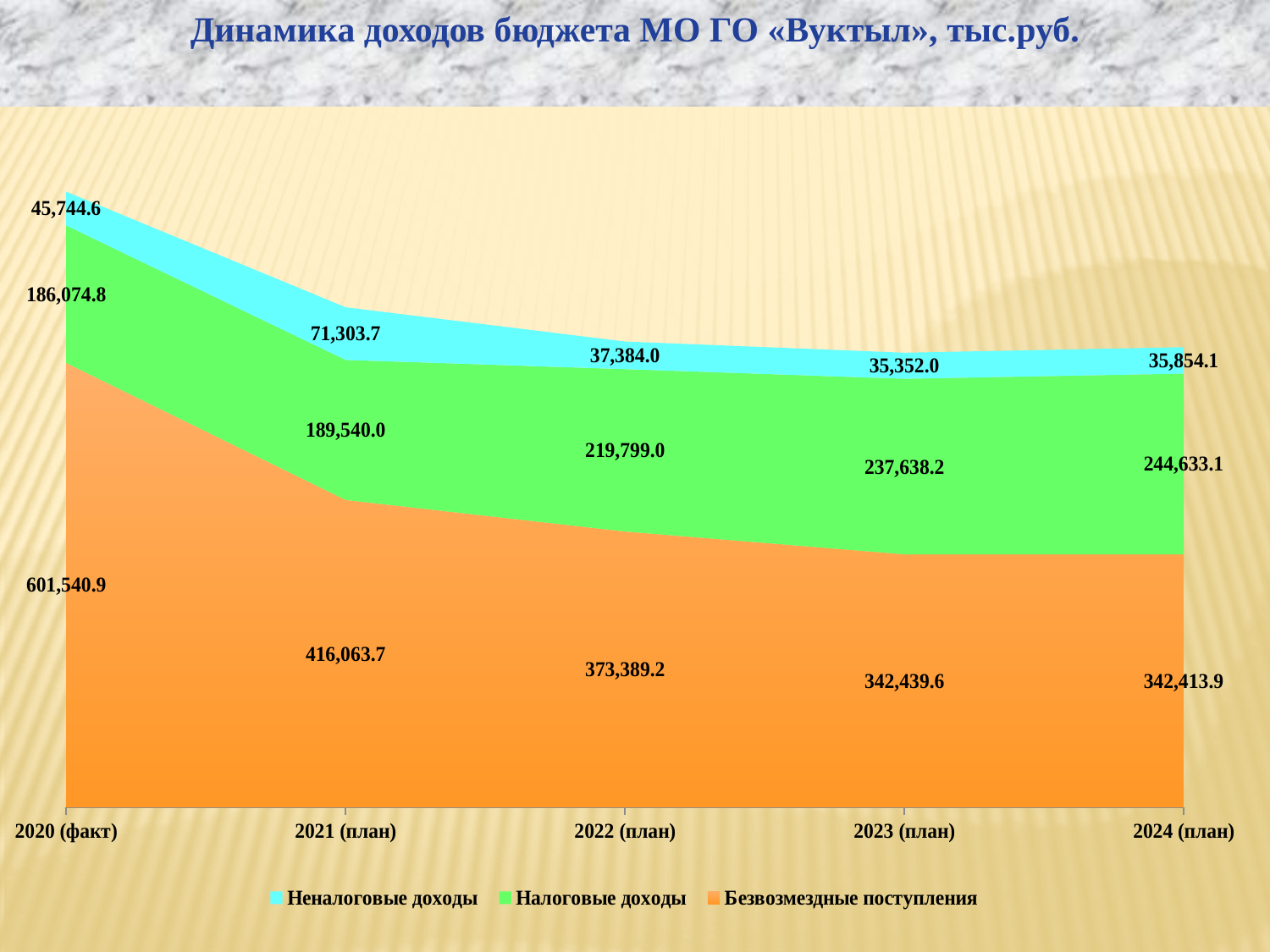
What is the total of all three series for 2024 (план)? 622,901.1 What is the difference between Налоговые доходы in 2024 (план) and in 2020 (факт)? 58,558.3 What is the value of Безвозмездные поступления for 2020 (факт)? 601,540.9 In which period is Неналоговые доходы highest? 2021 (план) What is the value of Налоговые доходы for 2022 (план)? 219,799.0 In which period is Безвозмездные поступления lowest? 2024 (план) How many series does the legend list? 3 What type of chart is shown on the slide? Stacked area chart How many periods are shown along the x axis? 5 Do the values of Налоговые доходы rise or fall from 2020 (факт) to 2024 (план)? Rise What is the value of Неналоговые доходы for 2021 (план)? 71,303.7 Which is larger: Безвозмездные поступления in 2021 (план) or in 2022 (план)? 2021 (план)